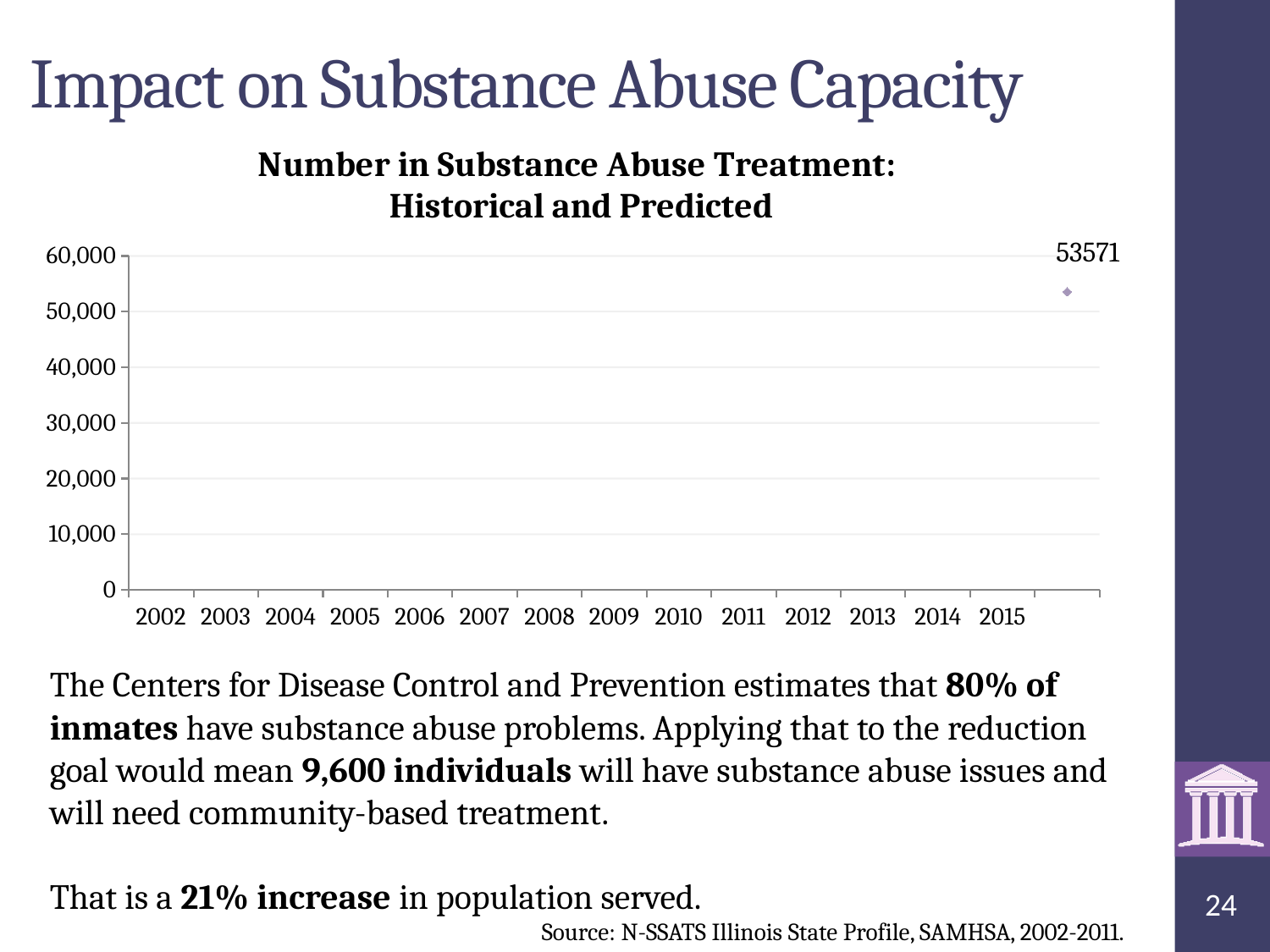
What is the last year labelled on the x axis of the chart? 2015 What is the title of the chart? Number in Substance Abuse Treatment: Historical and Predicted What is the highest value shown on the y axis of the chart? 60,000 Is the value of the plotted point (labelled 53571) greater or less than 60,000? less What value is printed as the data label on the single plotted point in the chart? 53571 Is the value of the plotted point (labelled 53571) greater or less than 50,000? greater How many year labels are shown along the x axis of the chart? 14 What is the first year labelled on the x axis of the chart? 2002